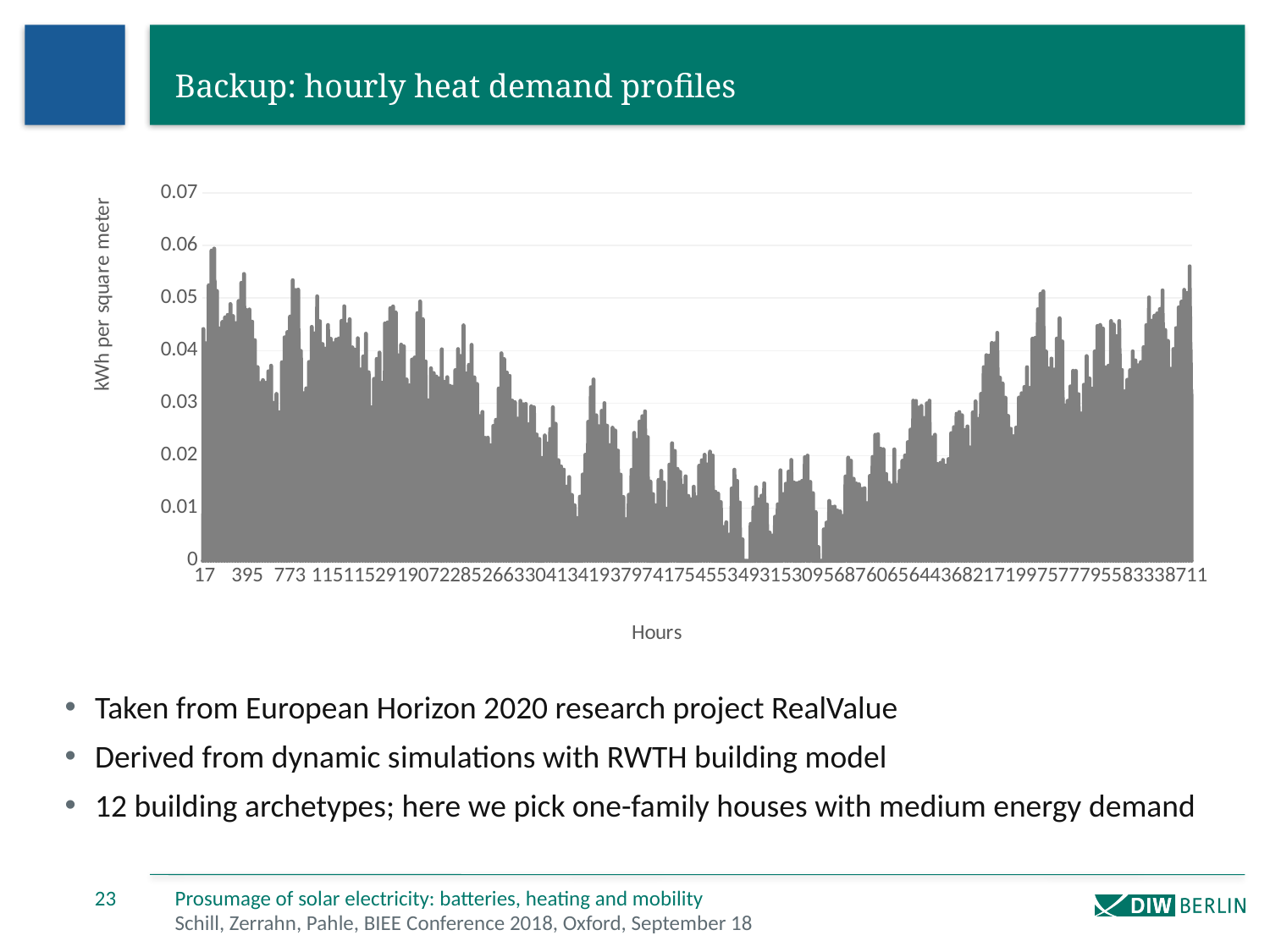
What is the label of the horizontal axis of the chart? Hours What kind of chart is shown on the slide? bar chart Is the highest value in the chart greater or less than 0.07? less What is the label of the vertical axis of the chart? kWh per square meter Are the values around hour 4553 greater or less than 0.03? less Do the values generally rise or fall along the x axis from hour 17 to around hour 4553? fall Are the values around hour 8711 greater or less than 0.02? greater Is the heat demand around hour 4553 larger or smaller than around hour 17? smaller Do the values generally rise or fall along the x axis from around hour 4553 to hour 8711? rise